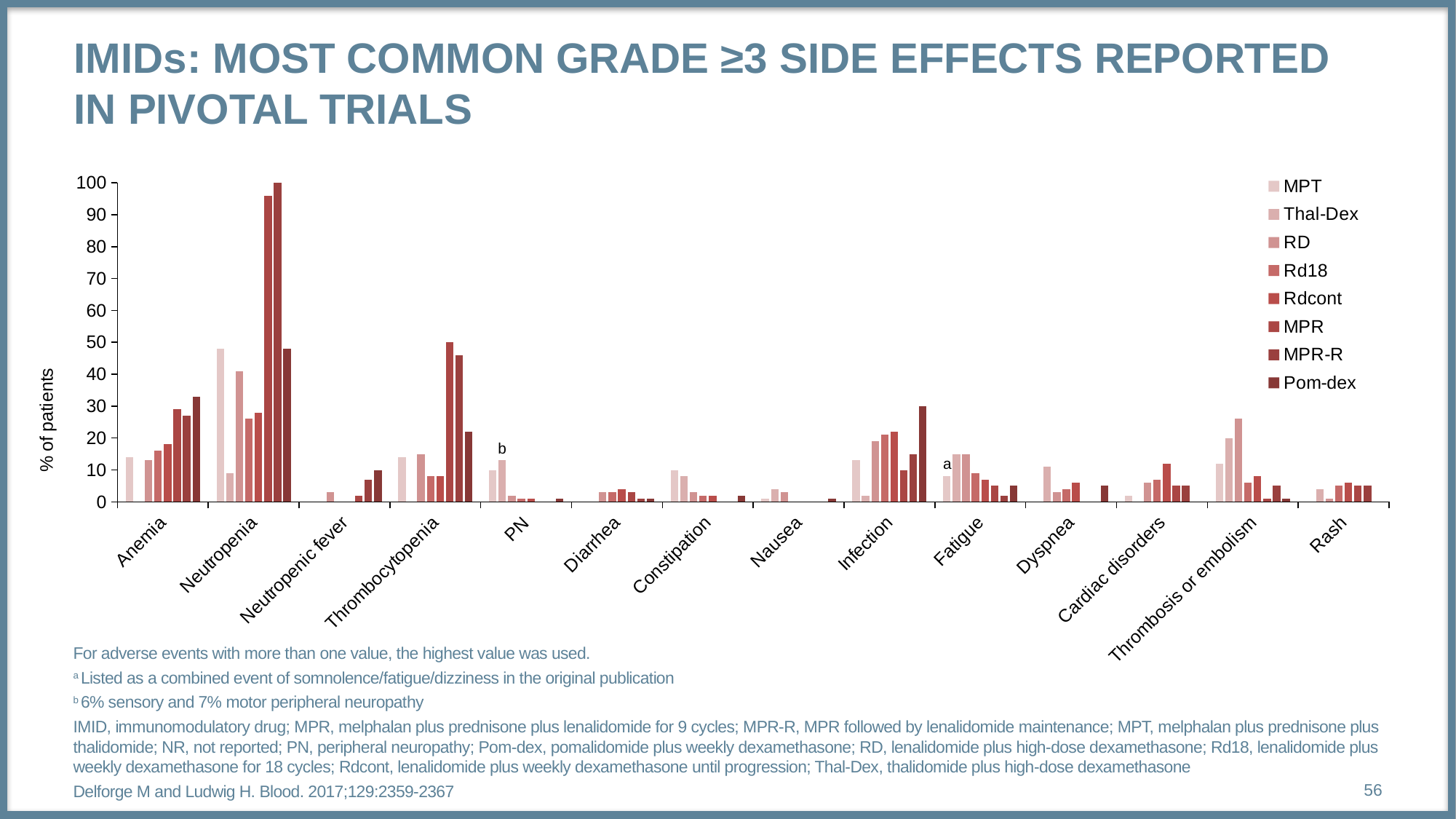
Which is larger for MPT: the value for Anemia or the value for Neutropenia? Neutropenia What is the label on the y axis of the chart? % of patients Is the Pom-dex value for Anemia greater or less than 30? greater How many series does the legend list? 8 Which side-effect category contains the tallest bar in the chart? Neutropenia Is the Rd18 value for Rash greater or less than 10? less Which is larger for Pom-dex: the value for Infection or the value for Fatigue? Infection How many side-effect categories are shown along the x axis? 14 What kind of chart is shown on the slide? bar chart Is the Thal-Dex value for Fatigue greater or less than 10? greater